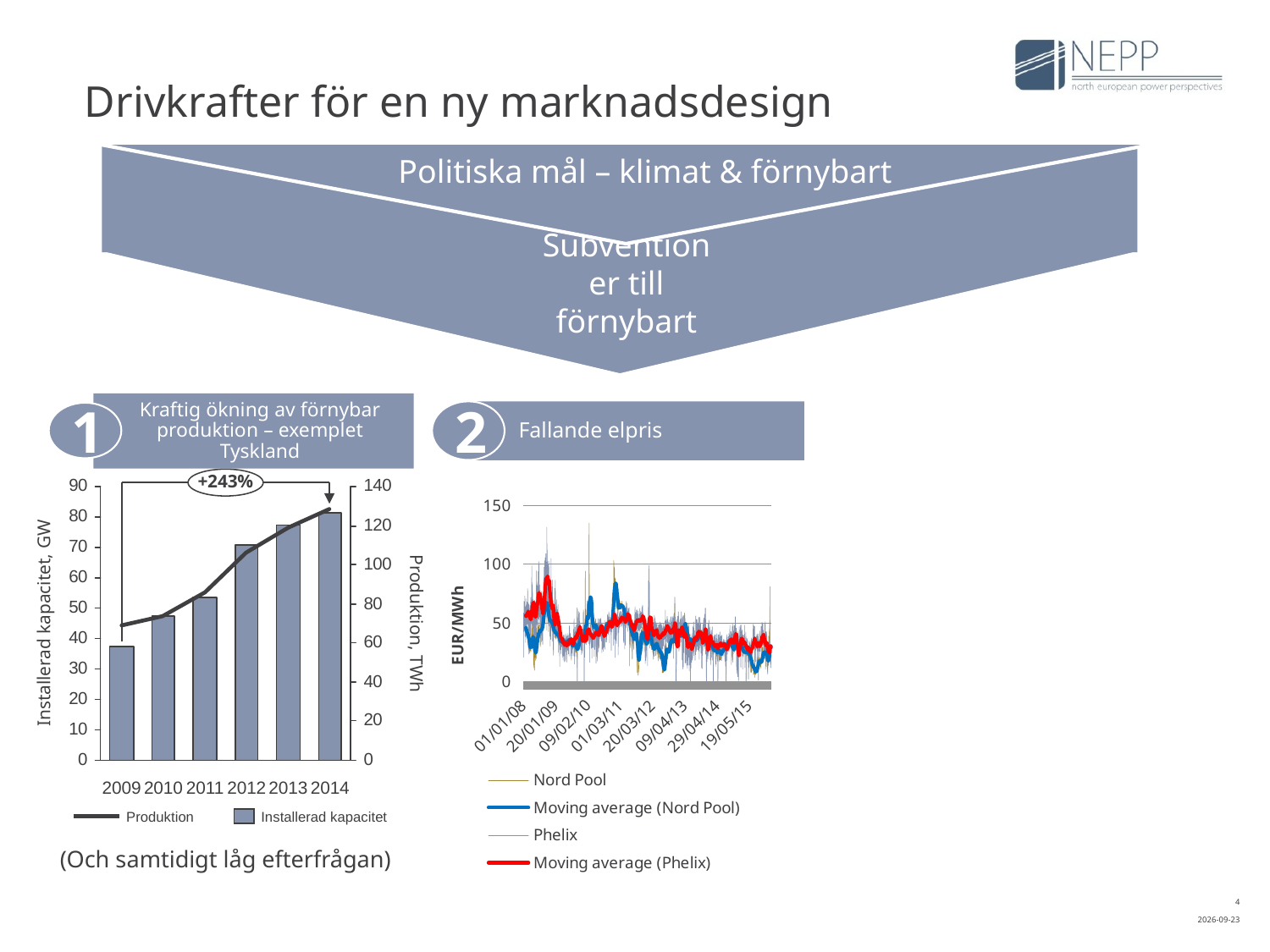
In the right chart (Fallande elpris), do the moving average prices generally rise or fall from 2008 to 2015? fall In the left chart (Kraftig ökning av förnybar produktion – exemplet Tyskland), does installed capacity rise or fall from 2009 to 2014? rise In the right chart (Fallande elpris), how many series does the legend list? 4 In the left chart (Kraftig ökning av förnybar produktion – exemplet Tyskland), which year has the highest installed capacity bar? 2014 In the left chart (Kraftig ökning av förnybar produktion – exemplet Tyskland), is the installed capacity for 2013 greater or less than 70 GW? greater In the left chart (Kraftig ökning av förnybar produktion – exemplet Tyskland), is the installed capacity for 2009 greater or less than 40 GW? less In the right chart (Fallande elpris), what kind of chart is it? line chart In the left chart (Kraftig ökning av förnybar produktion – exemplet Tyskland), which year has the lowest installed capacity bar? 2009 In the left chart (Kraftig ökning av förnybar produktion – exemplet Tyskland), which series is drawn as bars? Installerad kapacitet In the right chart (Fallande elpris), what is the unit shown on the y axis? EUR/MWh In the left chart (Kraftig ökning av förnybar produktion – exemplet Tyskland), how many years are shown on the x axis? 6 In the left chart (Kraftig ökning av förnybar produktion – exemplet Tyskland), what percentage increase is annotated above the bars? +243%